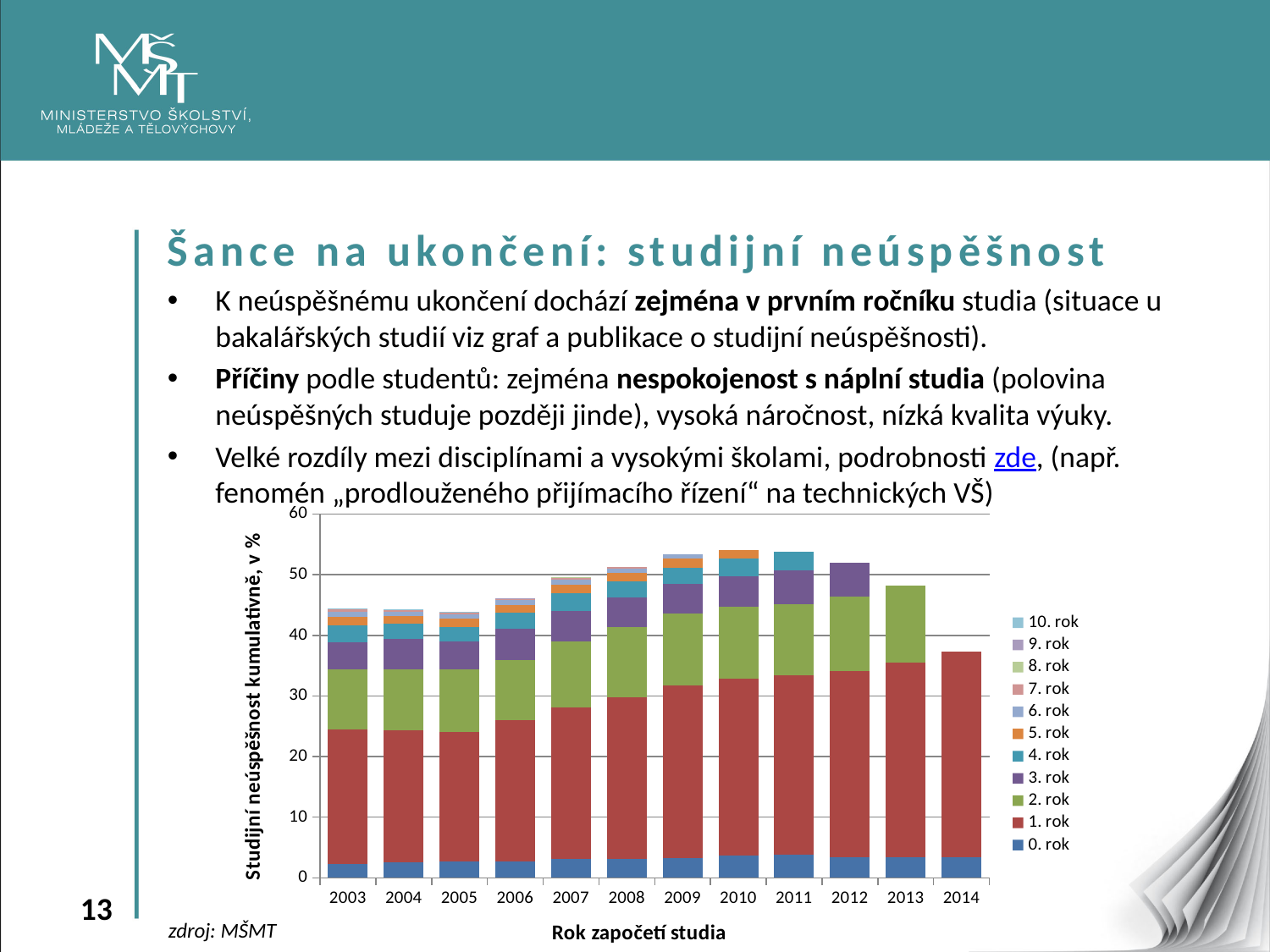
How many series does the chart legend list? 11 What kind of chart is shown on the slide? stacked bar chart What is the title of the x axis of the chart? Rok započetí studia Which year has the lowest total bar height in the chart? 2014 Is the total bar height for 2003 greater or less than 40? greater Is the total bar height for 2013 greater or less than 50? less What is the title of the y axis of the chart? Studijní neúspěšnost kumulativně, v % Does the total bar height rise or fall from 2003 to 2010? rise Which year has the larger total bar height, 2005 or 2008? 2008 Is the total bar height for 2014 greater or less than 40? less How many years (categories) are shown on the x axis of the chart? 12